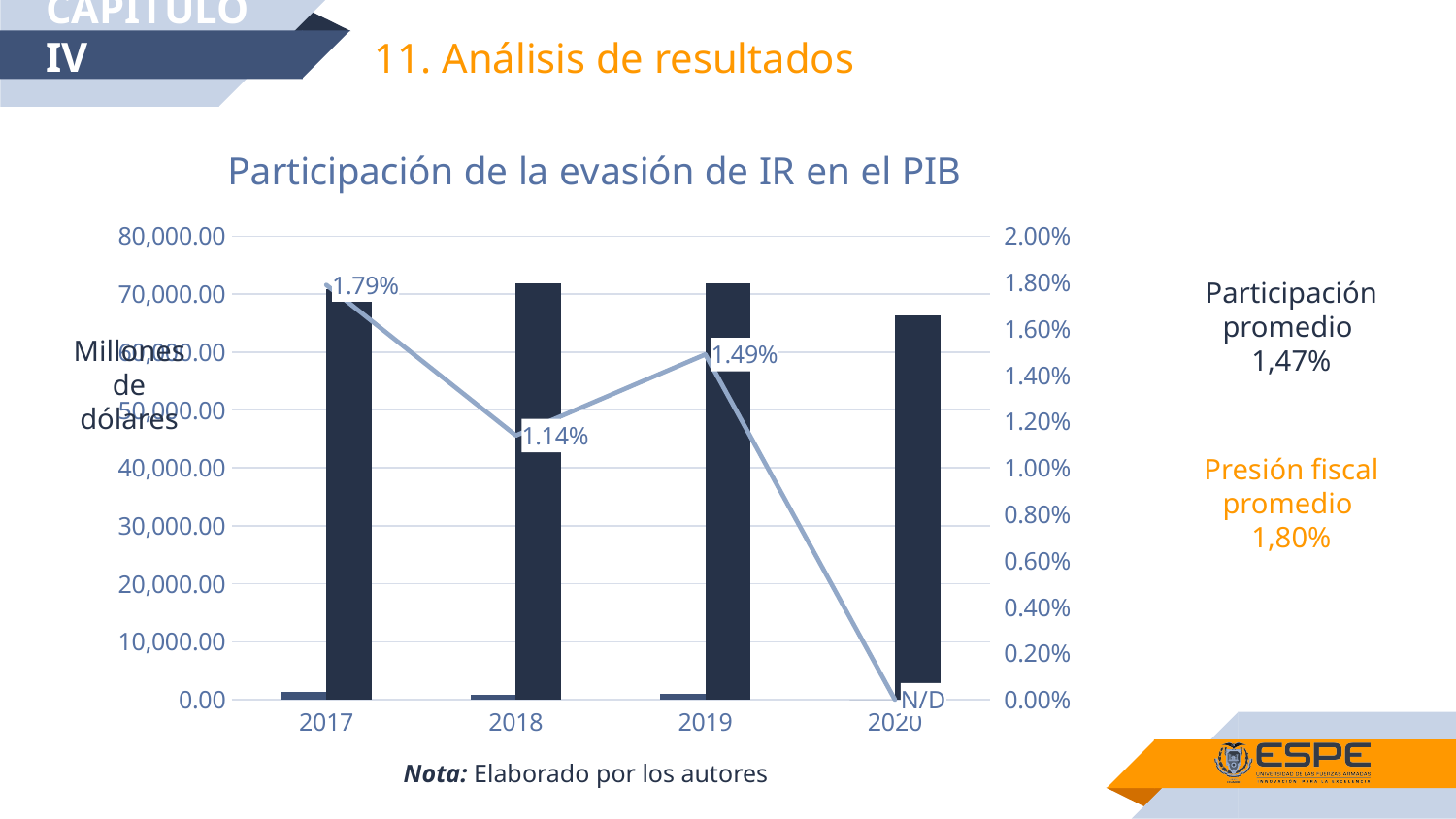
What is the title of the chart? Participación de la evasión de IR en el PIB Which is larger, the participation percentage for 2019 or for 2018? 2019 What is the participation percentage shown for 2018? 1.14% How many years are shown on the x axis? 4 What is the difference between the participation percentages for 2017 and 2018? 0.65% What label is shown for the participation value in 2020? N/D Is the value of the tall bar for 2020 greater or less than 70,000.00? less What is the participation percentage shown for 2019? 1.49% What is the participation percentage shown for 2017? 1.79% Which year has the highest participation percentage on the line? 2017 Among the years with a printed percentage, which year has the lowest participation? 2018 What is the difference between the participation percentages for 2019 and 2018? 0.35%